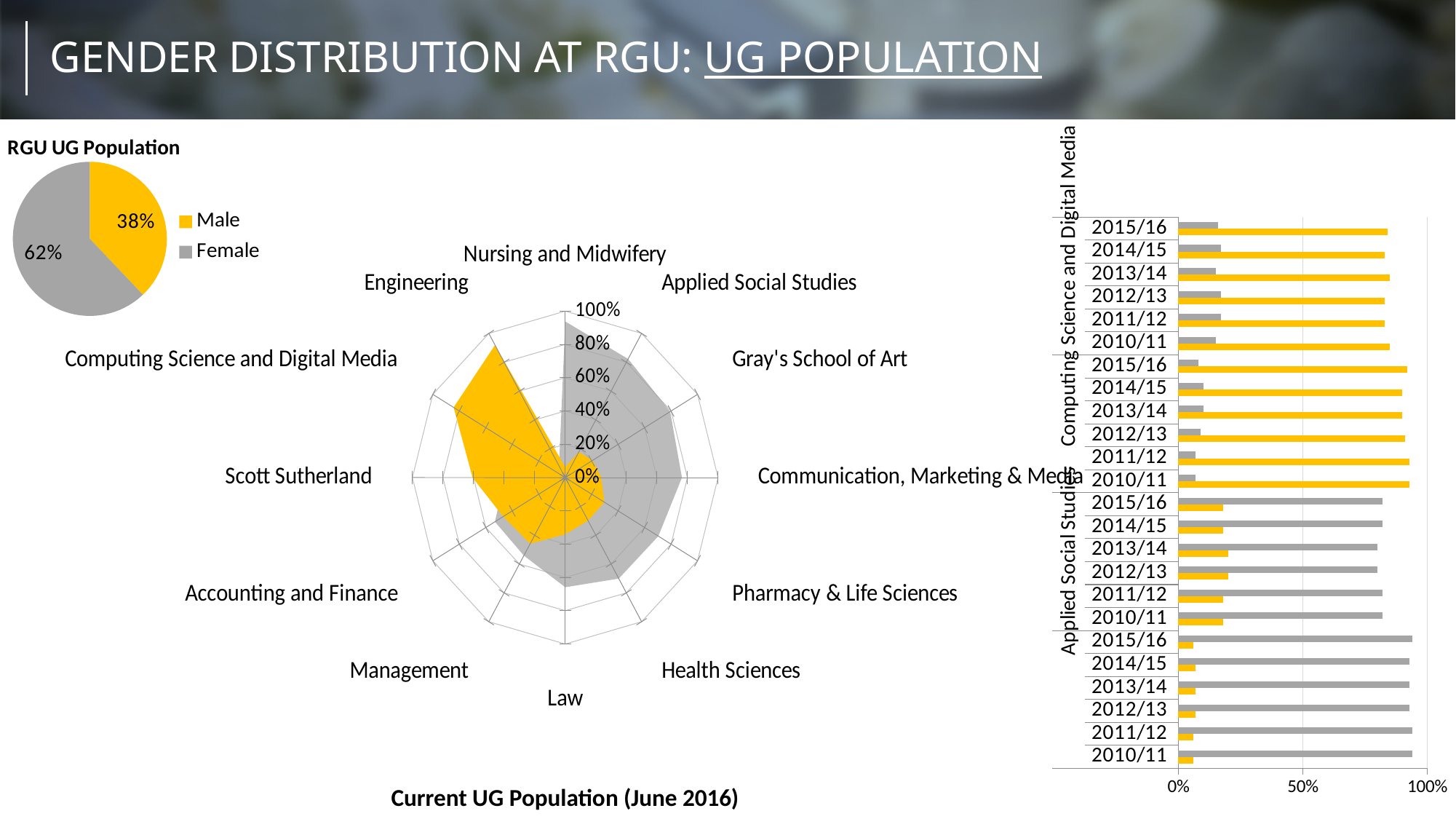
In the bar chart on the right side of the slide, is the yellow bar for Computing Science and Digital Media in 2015/16 greater or less than 50%? greater In the pie chart titled 'RGU UG Population', what is the difference in percentage points between the Female and Male slices? 24 percentage points What kind of chart is the chart on the right side of the slide showing years 2010/11 to 2015/16? Bar chart How many entries does the legend of the pie chart titled 'RGU UG Population' list? 2 In the radar chart titled 'Current UG Population (June 2016)', is the grey (Female) value for Nursing and Midwifery greater or less than 80%? greater In the radar chart titled 'Current UG Population (June 2016)', is the yellow (Male) value for Computing Science and Digital Media greater or less than 60%? greater In the pie chart titled 'RGU UG Population', which slice is larger, Male or Female? Female What kind of chart is the chart titled 'Current UG Population (June 2016)' in the middle of the slide? Radar chart How many schools (categories) are shown around the radar chart titled 'Current UG Population (June 2016)'? 12 In the bar chart on the right side of the slide, which bar is longer for Applied Social Studies in 2015/16, the yellow bar or the grey bar? The grey bar In the pie chart titled 'RGU UG Population', what percentage is Female? 62% In the pie chart titled 'RGU UG Population', what percentage is Male? 38%